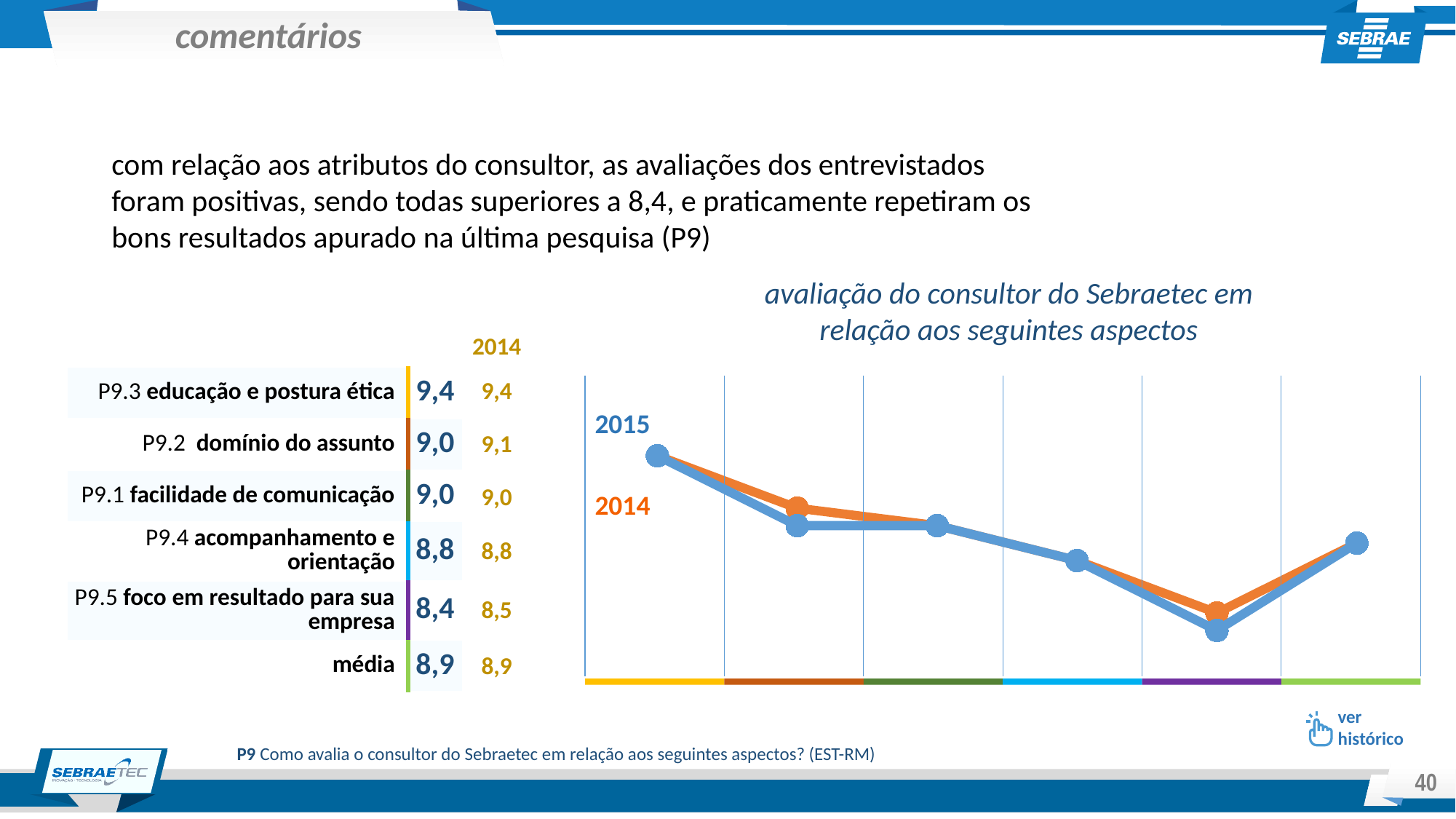
For P9.2 domínio do assunto, which year has the larger value, 2014 or 2015? 2014 Which aspect has the lowest 2015 value? P9.5 foco em resultado para sua empresa What is the 2015 value for P9.3 educação e postura ética? 9,4 What is the difference between the 2015 values for P9.3 educação e postura ética and P9.5 foco em resultado para sua empresa? 1,0 What is the 2015 value for média? 8,9 Which two years are plotted as series in the line chart? 2015 and 2014 Which aspect has the highest 2015 value? P9.3 educação e postura ética What is the 2015 value for P9.5 foco em resultado para sua empresa? 8,4 What type of chart is shown under the title "avaliação do consultor do Sebraetec em relação aos seguintes aspectos"? line chart What is the 2014 value for P9.2 domínio do assunto? 9,1 How many data points does each series in the line chart have? 6 How many series are plotted in the line chart? 2